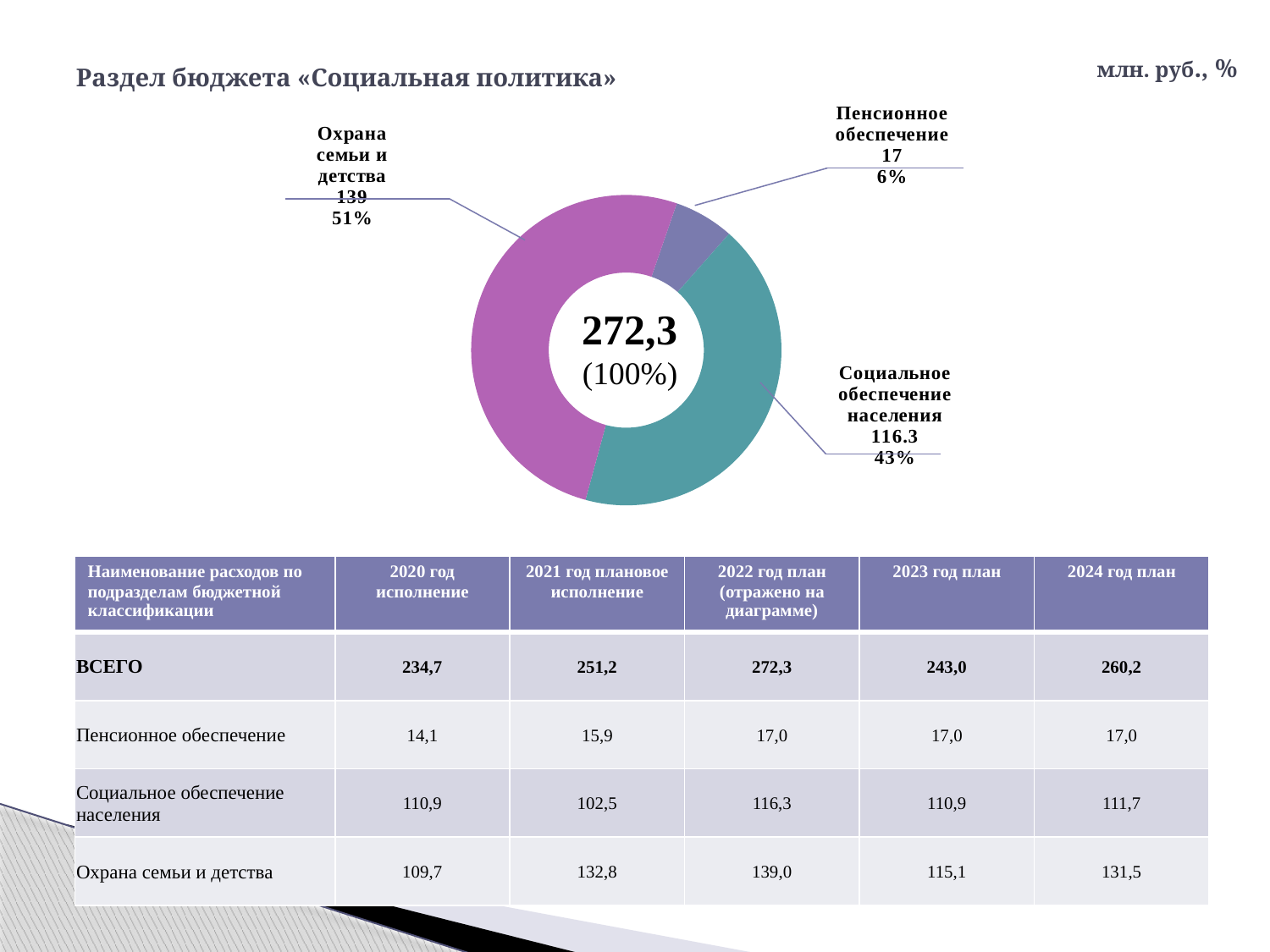
What total value is shown in the centre of the donut chart? 272,3 What share of the chart does «Охрана семьи и детства» represent? 51% What is the value shown for «Социальное обеспечение населения» on the chart? 116.3 What kind of chart is shown on the slide? Pie (donut) chart How many slices does the donut chart have? 3 Which is larger on the chart: «Охрана семьи и детства» or «Социальное обеспечение населения»? Охрана семьи и детства What share of the chart does «Пенсионное обеспечение» represent? 6% Which category has the largest slice in the chart? Охрана семьи и детства What share of the chart does «Социальное обеспечение населения» represent? 43% Which category has the smallest slice in the chart? Пенсионное обеспечение What is the value shown for «Охрана семьи и детства» on the chart? 139 What is the value shown for «Пенсионное обеспечение» on the chart? 17